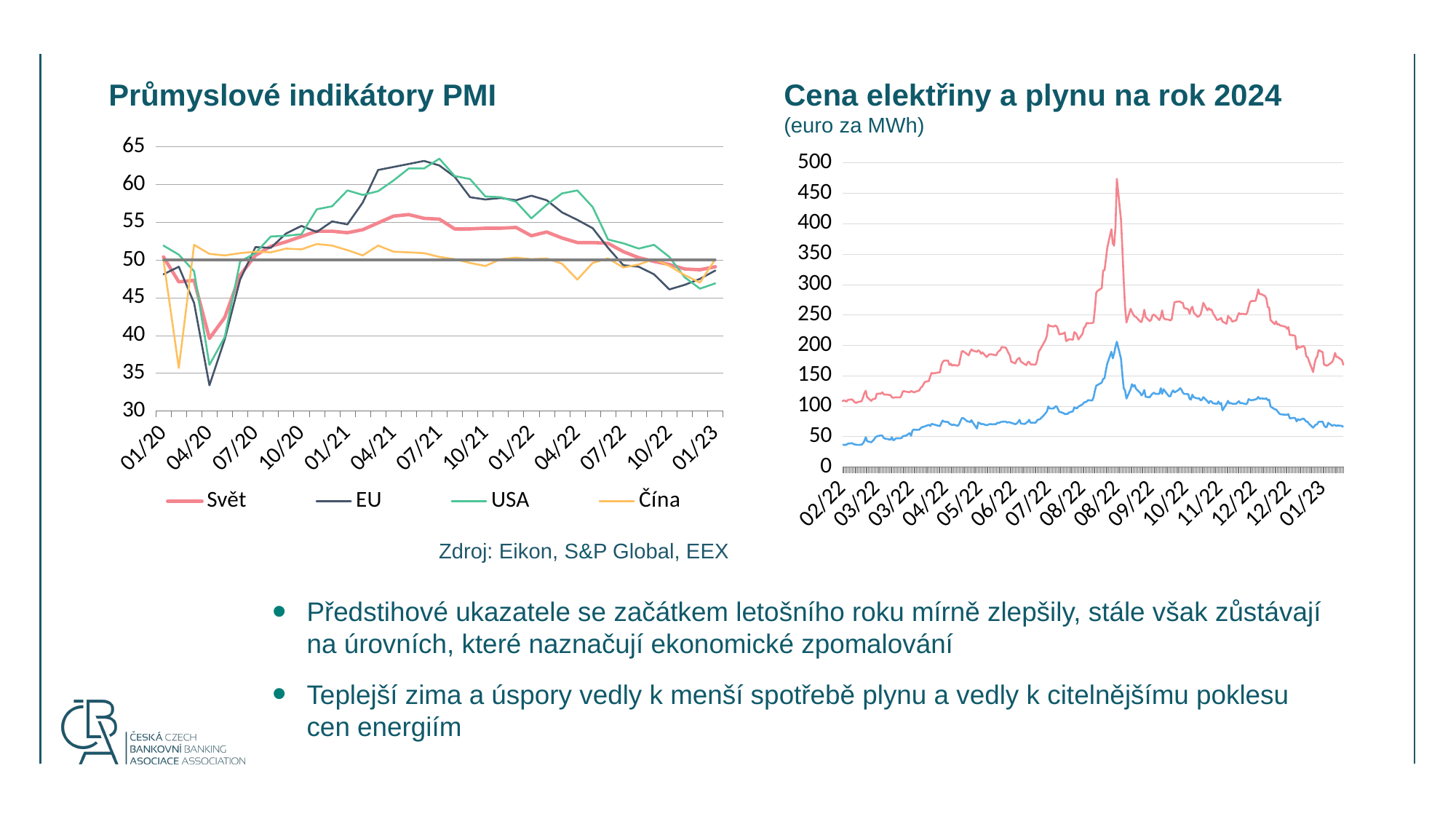
How many series does the legend of the 'Průmyslové indikátory PMI' chart list? 4 What unit is given under the title of the 'Cena elektřiny a plynu na rok 2024' chart? euro za MWh What kind of chart is the 'Cena elektřiny a plynu na rok 2024' chart on the right? line chart In the 'Cena elektřiny a plynu na rok 2024' chart, is the peak of the red line around 08/22 greater or less than 400? greater In the 'Průmyslové indikátory PMI' chart, is the peak value of the USA series around 07/21 greater or less than 60? greater In the 'Cena elektřiny a plynu na rok 2024' chart, is the peak of the blue line around 08/22 greater or less than 150? greater What kind of chart is the 'Průmyslové indikátory PMI' chart on the left? line chart In the 'Průmyslové indikátory PMI' chart, which series are listed in the legend? Svět, EU, USA, Čína In the 'Cena elektřiny a plynu na rok 2024' chart, do the values of the red line rise or fall between the 08/22 peak and 01/23? fall